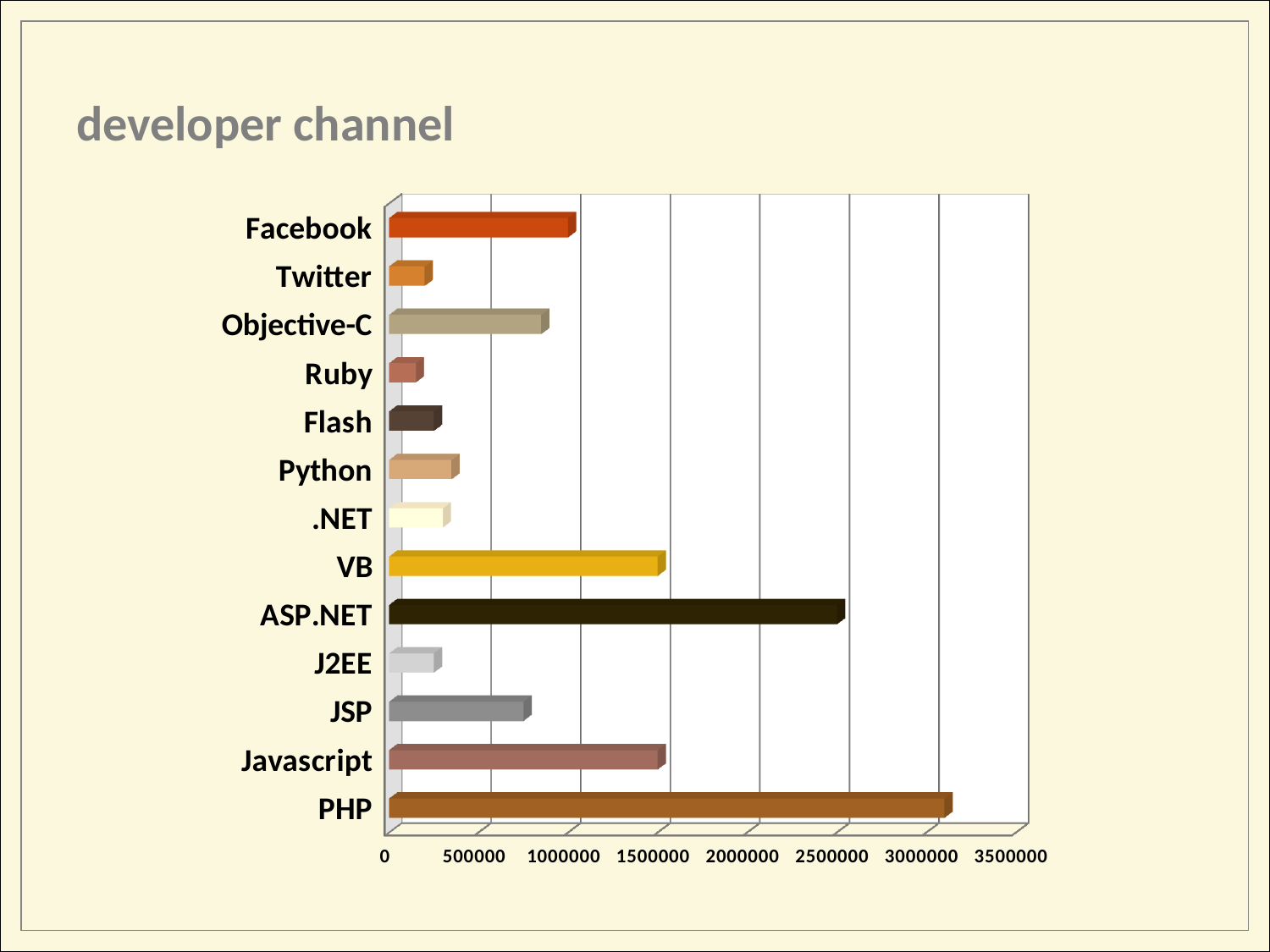
Is the value for PHP greater or less than 3000000? greater Is the value for Objective-C greater or less than 1000000? less Which category has the highest value in the chart? PHP Is the value for JSP greater or less than 500000? greater Which has the larger value, ASP.NET or VB? ASP.NET What kind of chart is shown on the slide? bar chart Which has the larger value, Facebook or Objective-C? Facebook How many categories are plotted in the chart? 13 What is the title of the slide containing the chart? developer channel